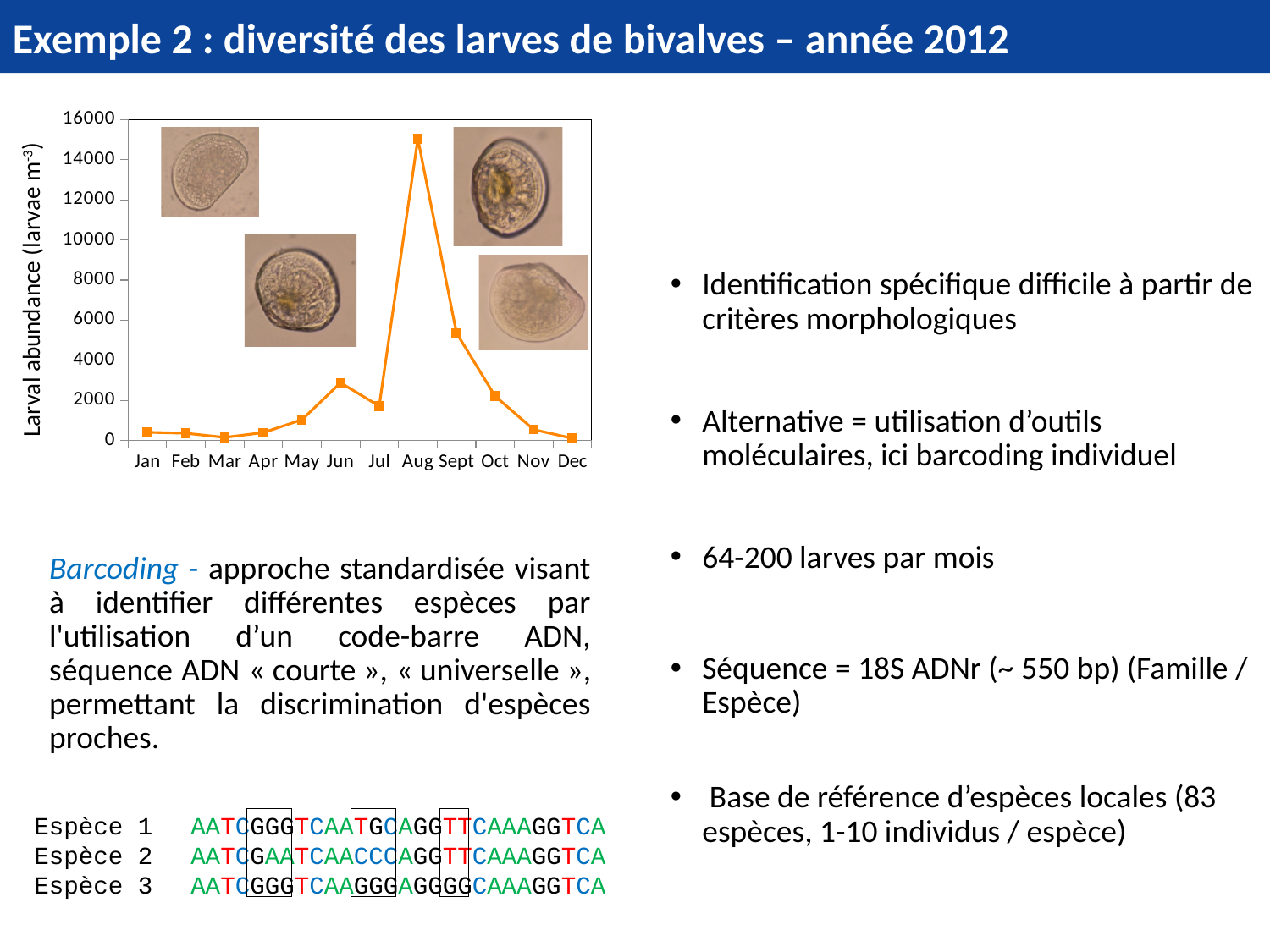
Is the larval abundance for Sept greater or less than 6000? less What kind of chart is shown on the slide? line chart Is the larval abundance for Aug greater or less than 14000? greater In which month is larval abundance highest? Aug Is the larval abundance for Jun greater or less than 4000? less Which month has the larger larval abundance, Jun or Jul? Jun Do the values rise or fall from Aug to Dec? fall What is the label of the y axis of the chart? Larval abundance (larvae m-3) How many months are plotted along the x axis of the chart? 12 Which month has the larger larval abundance, Aug or Sept? Aug